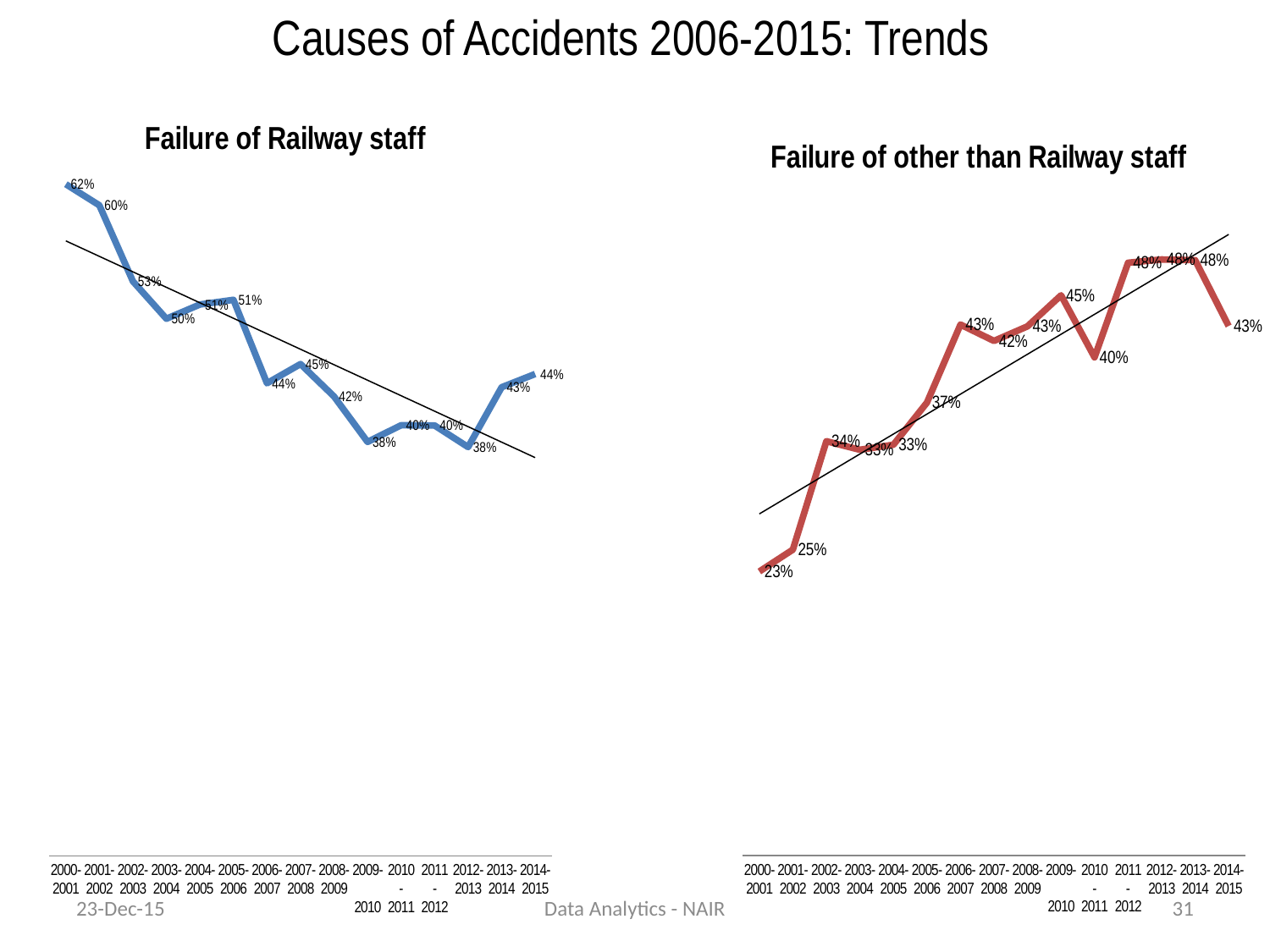
What kind of chart is 'Failure of other than Railway staff'? Line chart In the 'Failure of Railway staff' chart, what is the difference between the values for 2000-2001 and 2014-2015? 18% In the 'Failure of other than Railway staff' chart, which period has the lowest value? 2000-2001 In the 'Failure of other than Railway staff' chart, do the values generally rise or fall from 2000-2001 to 2014-2015? Rise In the 'Failure of Railway staff' chart, what is the value for 2014-2015? 44% In the 'Failure of other than Railway staff' chart, what is the value for 2014-2015? 43% In the 'Failure of Railway staff' chart, which period has the highest value? 2000-2001 In the 'Failure of other than Railway staff' chart, what is the value for 2000-2001? 23% In the 'Failure of other than Railway staff' chart, which is larger, the value for 2009-2010 or the value for 2010-2011? 2009-2010 In the 'Failure of other than Railway staff' chart, what is the difference between the values for 2014-2015 and 2000-2001? 20% In the 'Failure of Railway staff' chart, what is the value for 2000-2001? 62% How many periods are plotted in the 'Failure of Railway staff' chart? 15